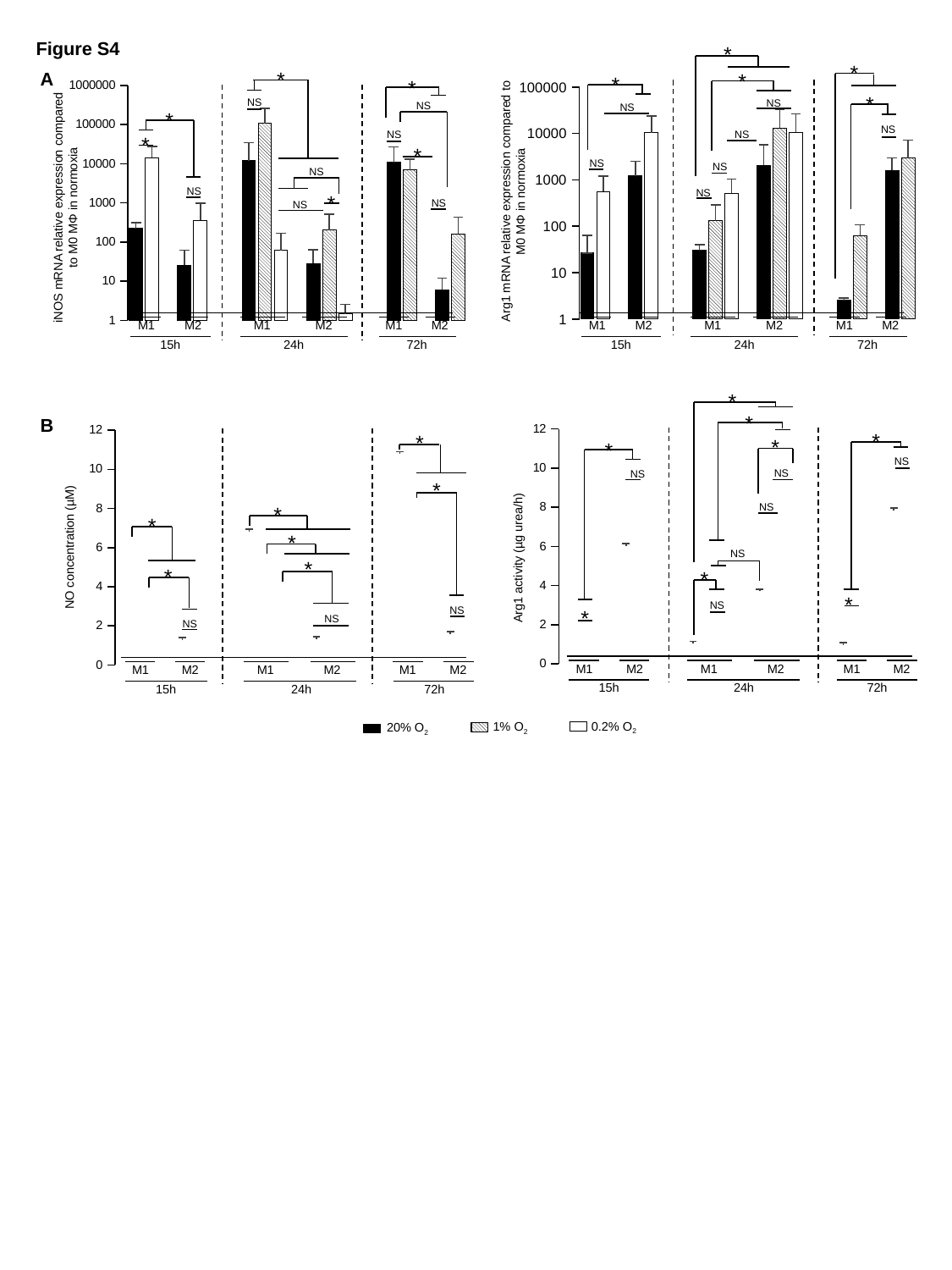
In the Arg1 activity chart (panel B, right), is the value for M2 at 72h greater or less than 6? greater In the Arg1 mRNA chart (panel A, right), is the value for the 1% O2 bar at M1, 72h greater or less than 100? less In the iNOS mRNA chart (panel A, left), is the value for the 0.2% O2 bar at M1, 15h greater or less than 10000? greater What kind of chart is the iNOS mRNA relative expression chart in panel A? bar chart How many series does the legend at the bottom of the slide list? 3 In the Arg1 mRNA chart (panel A, right), for the 0.2% O2 series at 15h, which is larger: M1 or M2? M2 How many time points (15h, 24h, 72h) are shown along the x axis of the NO concentration chart in panel B? 3 In the iNOS mRNA chart (panel A, left), at M1, 15h, which is larger: the 20% O2 bar or the 0.2% O2 bar? 0.2% O2